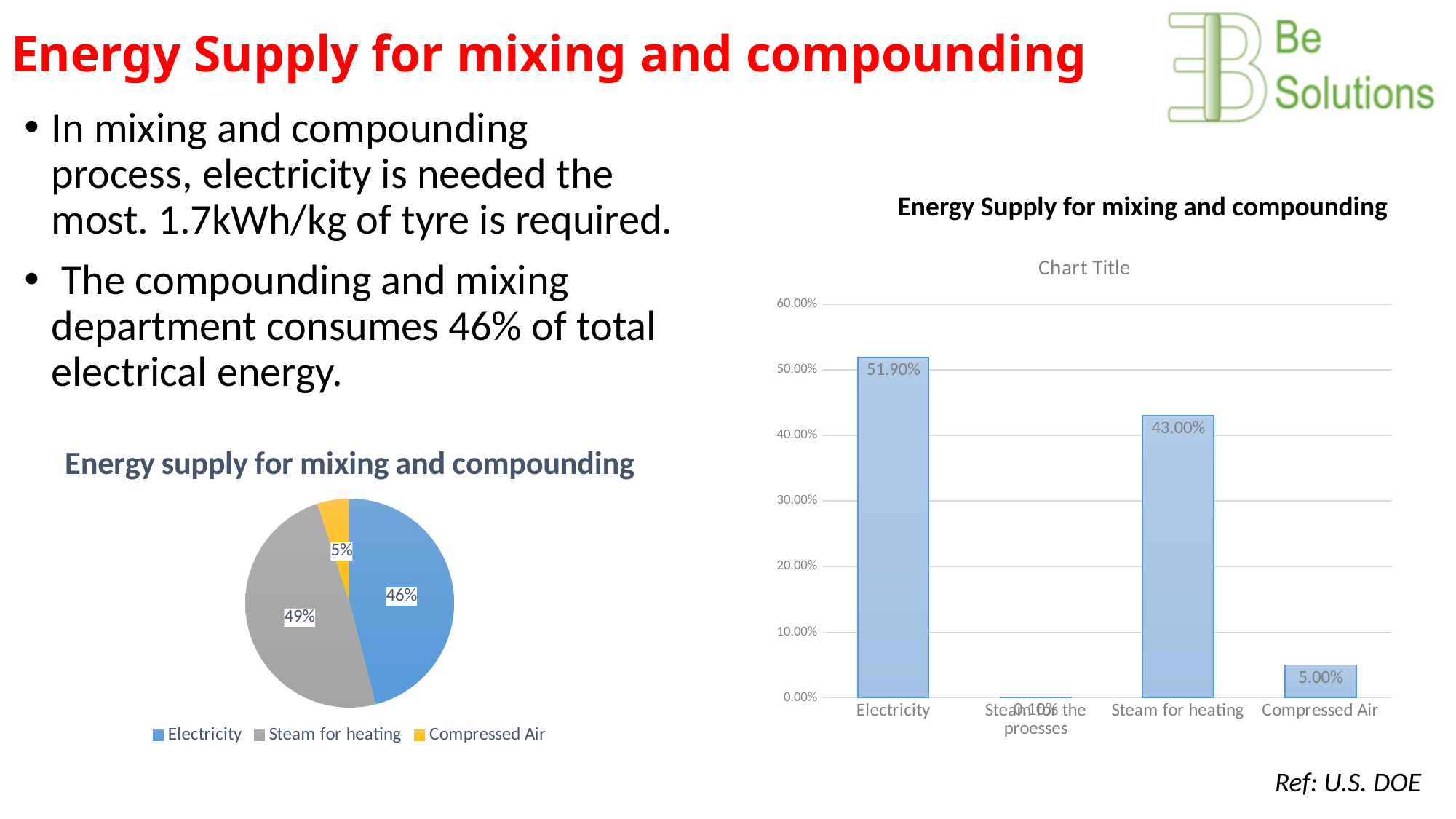
What type of chart is the chart on the right of the slide? Bar chart In the pie chart on the left, how many categories does the legend list? 3 What type of chart is the chart on the left of the slide? Pie chart In the pie chart on the left, what share does Steam for heating have? 49% In the pie chart on the left, what share does Compressed Air have? 5% In the bar chart on the right, which category has the highest value? Electricity In the pie chart on the left, which category has the largest slice? Steam for heating In the pie chart on the left, which category has the smallest slice? Compressed Air In the bar chart on the right, what is the value for Electricity? 51.90% In the bar chart on the right, how many bars (categories) are plotted? 4 In the bar chart on the right, what is the value for Steam for heating? 43.00% In the bar chart on the right, what is the difference between the Electricity and Steam for heating values? 8.90%